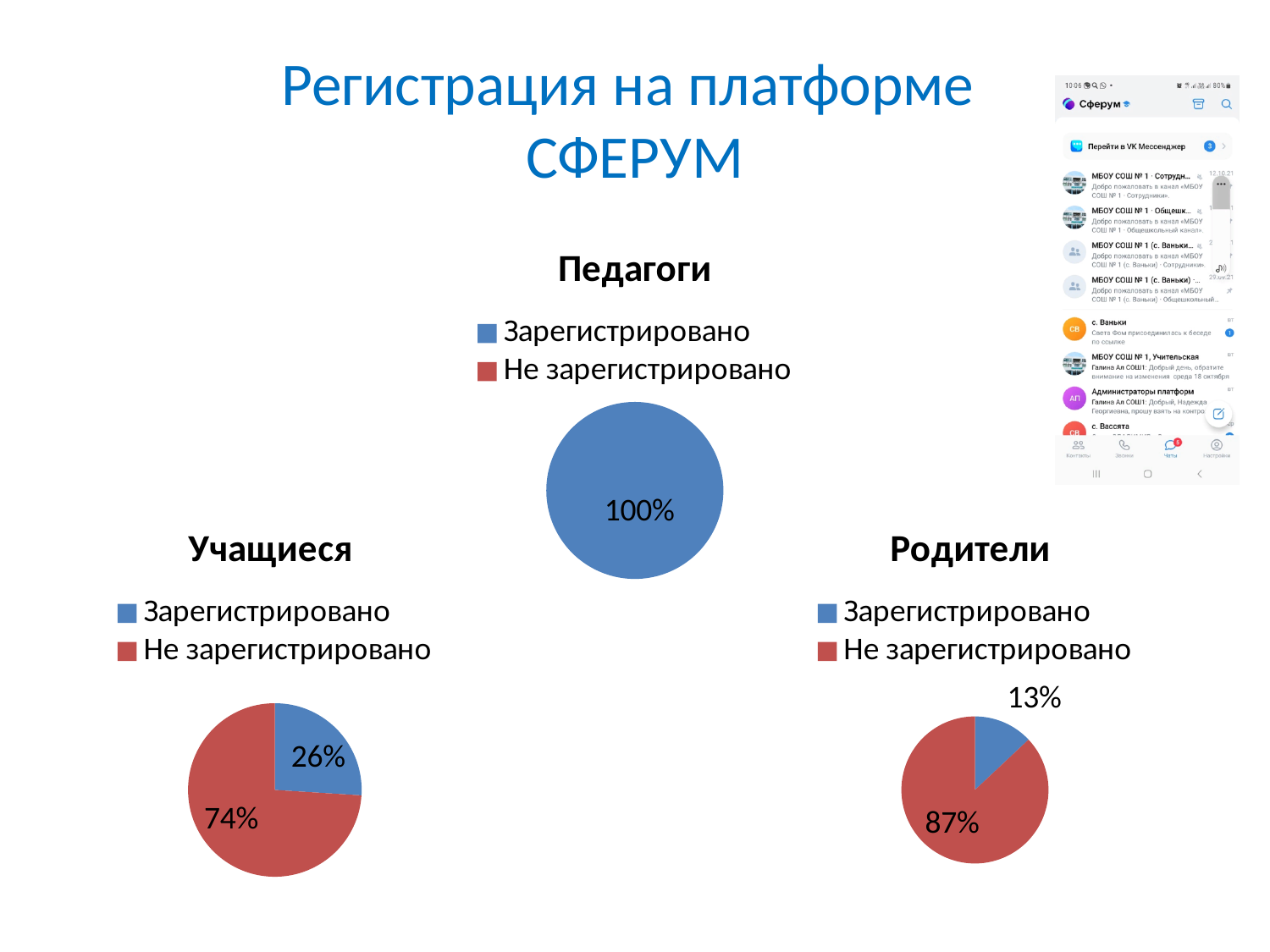
In the 'Учащиеся' chart, what share is labelled for 'Зарегистрировано'? 26% In the 'Родители' chart, what is the difference in percentage points between 'Не зарегистрировано' and 'Зарегистрировано'? 74 What type of chart is the 'Педагоги' chart? Pie chart How many pie charts are shown on the slide? 3 In the 'Родители' chart, what share is labelled for 'Не зарегистрировано'? 87% In the 'Педагоги' chart, what share is labelled for 'Зарегистрировано'? 100% How many entries does the legend of the 'Родители' chart list? 2 In the 'Учащиеся' chart, which slice is larger: 'Зарегистрировано' or 'Не зарегистрировано'? Не зарегистрировано In the 'Учащиеся' chart, what is the difference in percentage points between 'Не зарегистрировано' and 'Зарегистрировано'? 48 In the 'Родители' chart, what share is labelled for 'Зарегистрировано'? 13% In the 'Родители' chart, which slice is the smallest? Зарегистрировано In the 'Учащиеся' chart, what share is labelled for 'Не зарегистрировано'? 74%